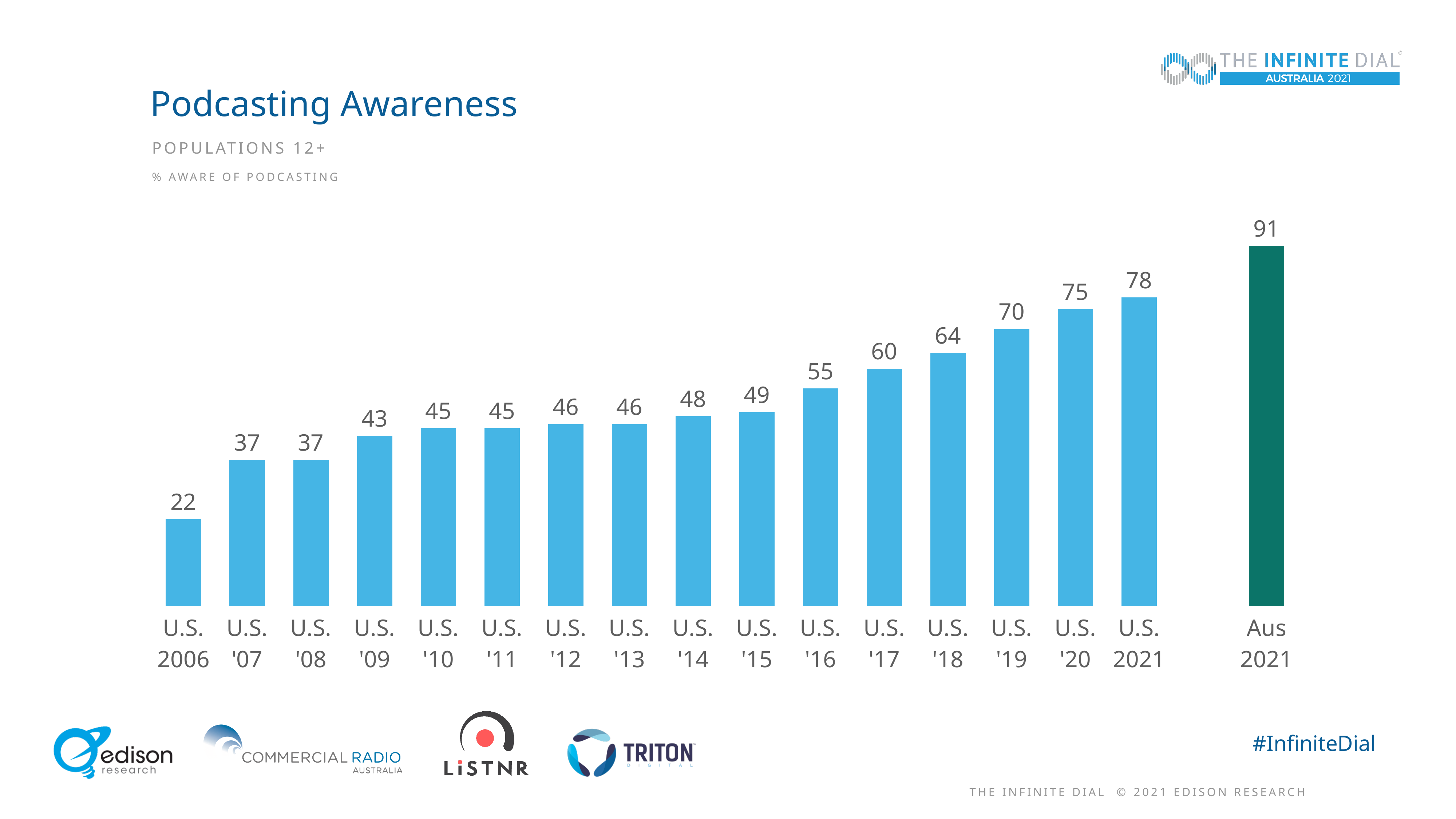
Which category has the highest value? Aus 2021 What is the difference between the values for U.S. '20 and U.S. '19? 5 What is the title of the chart? Podcasting Awareness What is the value for U.S. '16? 55 What is the difference between the values for Aus 2021 and U.S. 2021? 13 Which category has the lowest value? U.S. 2006 What kind of chart is shown on the slide? Bar chart Do the U.S. values generally rise or fall from 2006 to 2021? Rise What is the value for U.S. 2006? 22 How many bars are shown in the chart? 17 Which is larger, the value for U.S. '18 or the value for U.S. '17? U.S. '18 What is the value for Aus 2021? 91